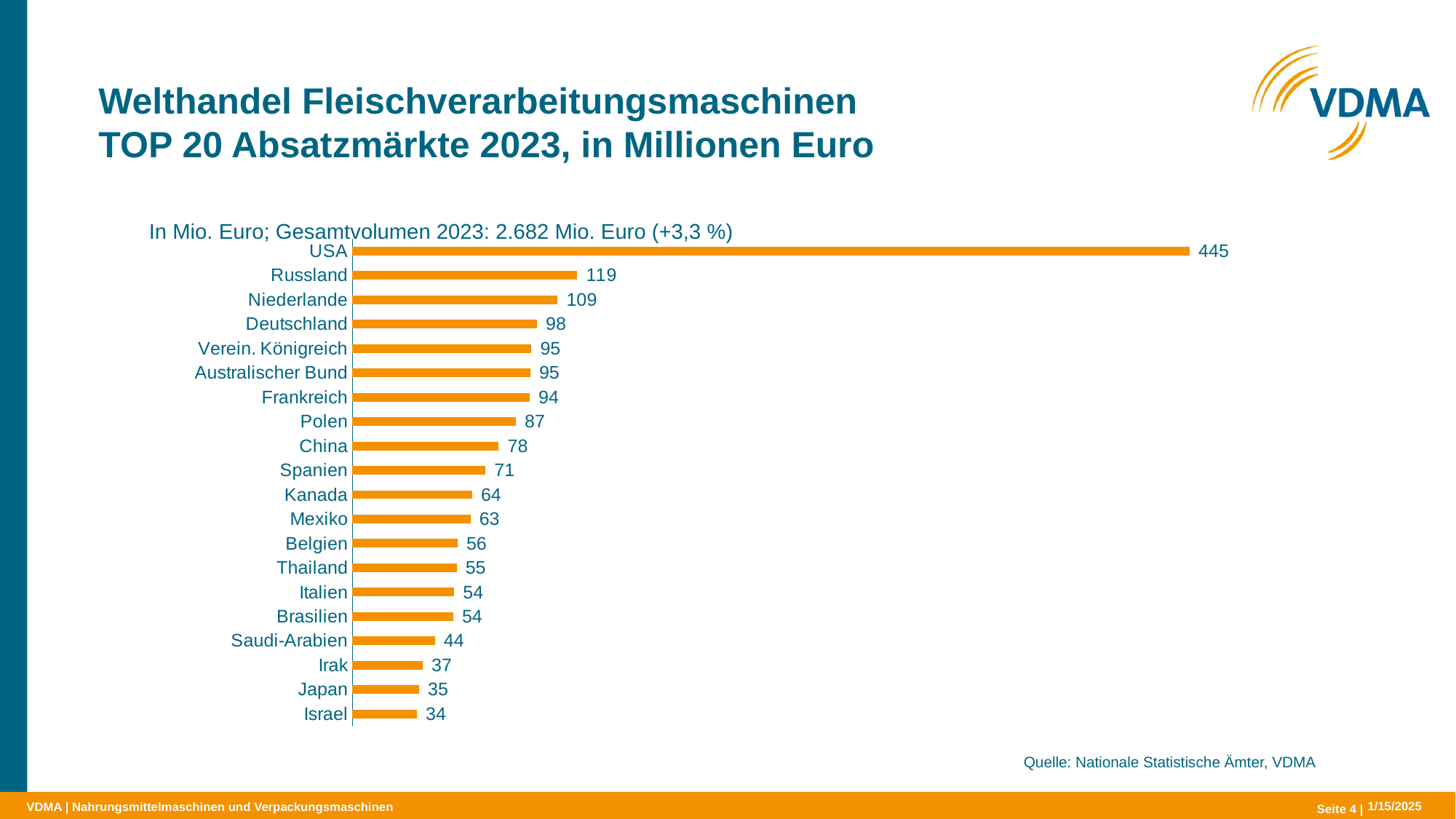
Which country has the highest value? USA Which country has the lowest value? Israel What is the difference between the values for USA and Russland? 326 What is the difference between the values for Deutschland and China? 20 What total volume for 2023 is stated in the chart subtitle? 2.682 Mio. Euro How many countries are shown in the chart? 20 What is the value for Saudi-Arabien? 44 What is the value for USA? 445 What kind of chart is shown on the slide? bar chart What is the value for Niederlande? 109 Which is larger, the value for Kanada or the value for Belgien? Kanada What is the value for Polen? 87